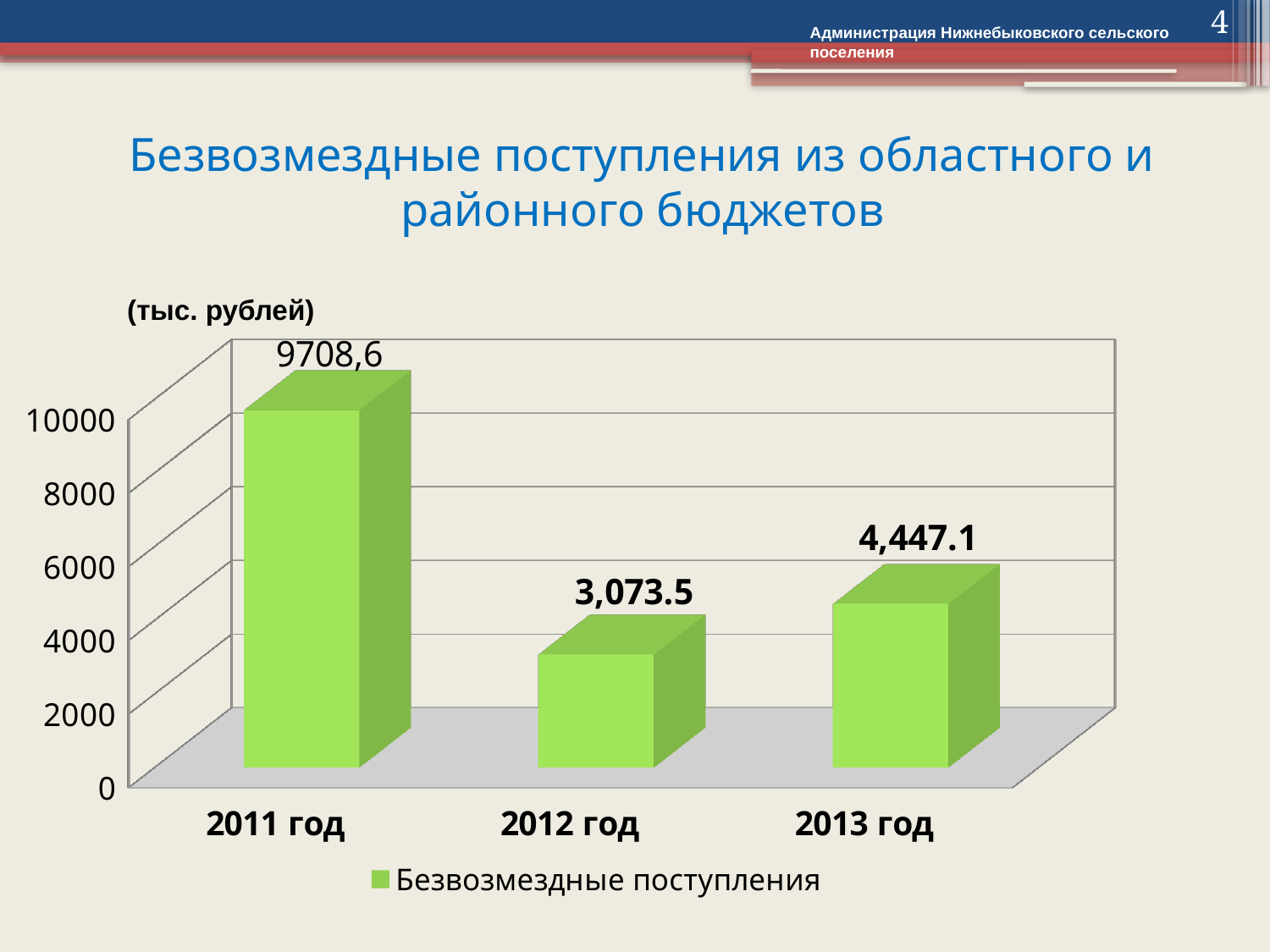
What series name is shown in the legend? Безвозмездные поступления Is the value for 2012 год greater or less than 4000? less What is the value for 2012 год? 3,073.5 Which is larger, the value for 2012 год or the value for 2013 год? 2013 год What is the difference between the values for 2013 год and 2012 год? 1,373.6 What is the value for 2013 год? 4,447.1 What is the value for 2011 год? 9708,6 Which year has the highest value? 2011 год How many years are shown on the chart? 3 How many series does the legend list? 1 Which year has the lowest value? 2012 год What kind of chart is shown on the slide? bar chart